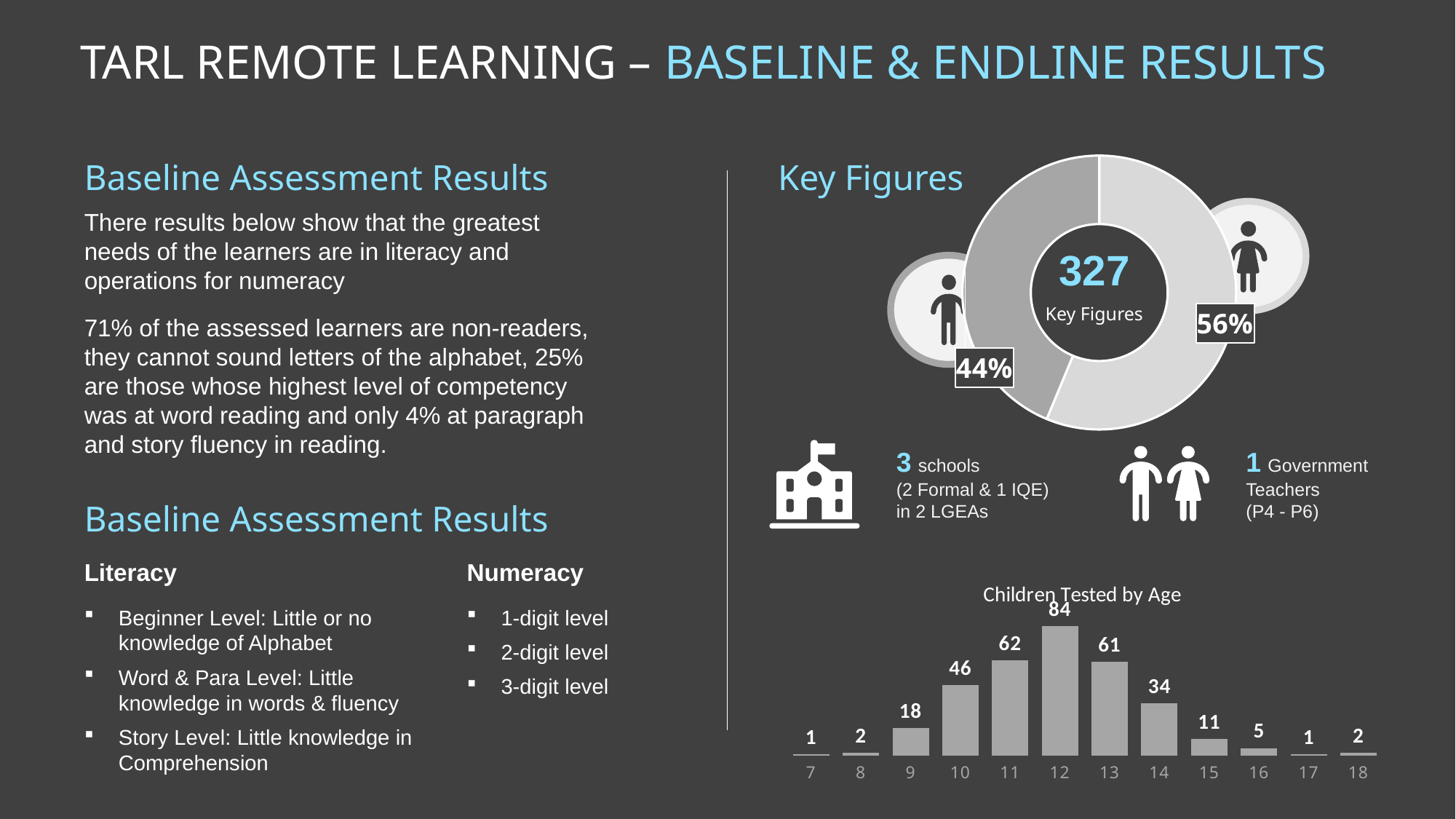
What kind of chart is 'Children Tested by Age'? Bar chart What number is shown in the centre of the 'Key Figures' donut chart? 327 In the 'Children Tested by Age' chart, what is the difference between the number of children tested at age 11 and at age 13? 1 In the 'Children Tested by Age' chart, what is the difference between the values for age 12 and age 9? 66 In the donut chart under 'Key Figures', what is the larger of the two percentages shown? 56% In the 'Children Tested by Age' chart, do the values rise or fall from age 12 to age 18? Fall In the 'Children Tested by Age' chart, which age has more children tested, 10 or 14? 10 In the 'Children Tested by Age' chart, how many children were tested at age 10? 46 In the 'Children Tested by Age' chart, which age has the highest number of children tested? 12 In the 'Children Tested by Age' chart, how many children were tested at age 12? 84 How many age categories are shown in the 'Children Tested by Age' chart? 12 In the 'Children Tested by Age' chart, how many children were tested at age 14? 34